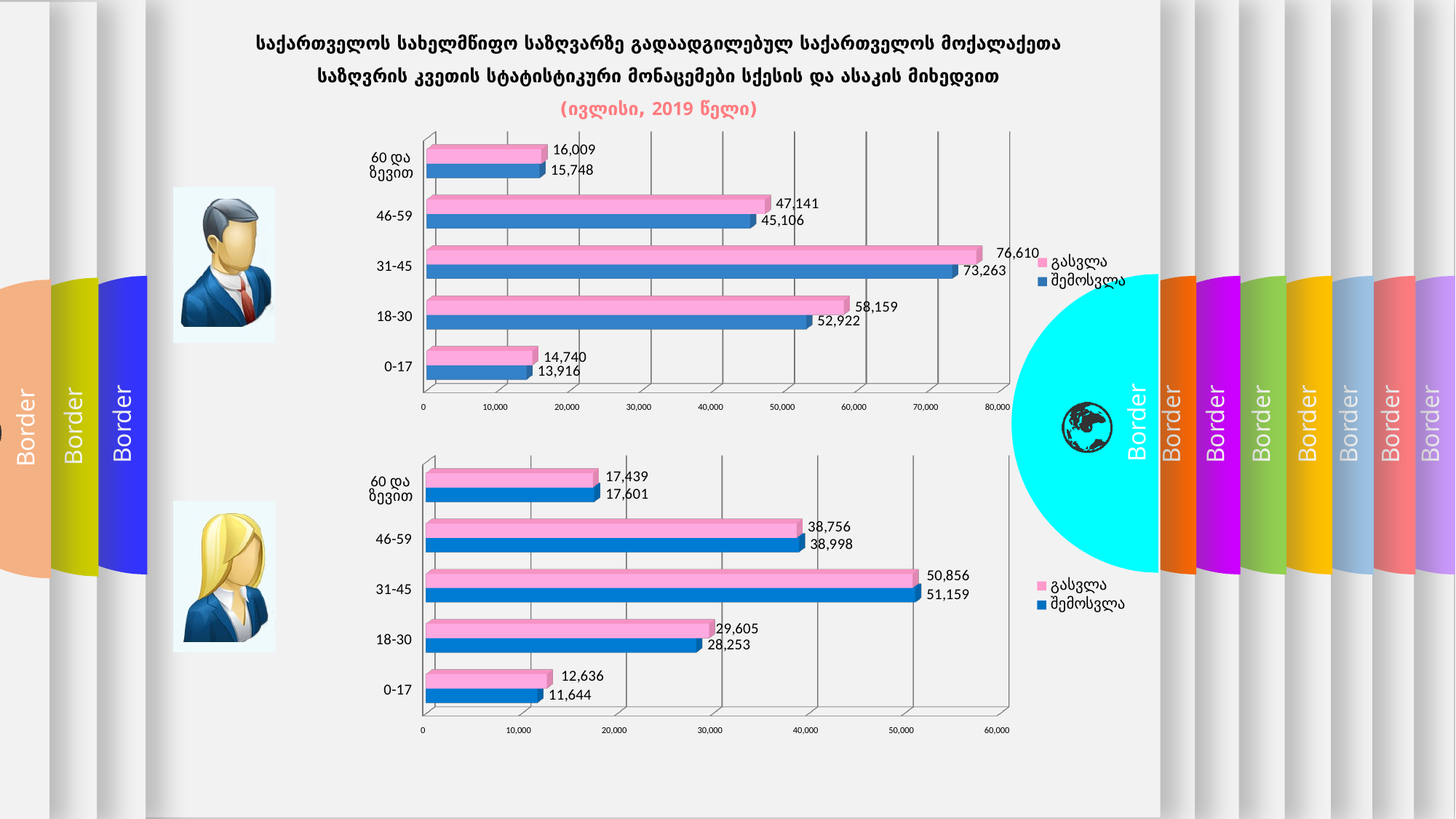
How many age groups are shown in the bottom chart? 5 In the top chart, which age group has the highest გასვლა value? 31-45 In the bottom chart, which age group has the lowest შემოსვლა value? 0-17 In the top chart, what is the difference between the გასვლა and შემოსვლა values for the 46-59 age group? 2,035 What type of chart is the bottom chart? bar chart In the bottom chart, what is the შემოსვლა value for the 46-59 age group? 38,998 How many series does the legend of the top chart list? 2 In the bottom chart, what is the გასვლა value for the 0-17 age group? 12,636 In the bottom chart, which is larger for the 31-45 age group, გასვლა or შემოსვლა? შემოსვლა In the top chart, what is the შემოსვლა value for the 18-30 age group? 52,922 In the top chart, what is the გასვლა value for the 31-45 age group? 76,610 In the top chart, is the შემოსვლა value for the 31-45 age group greater or less than 70,000? greater